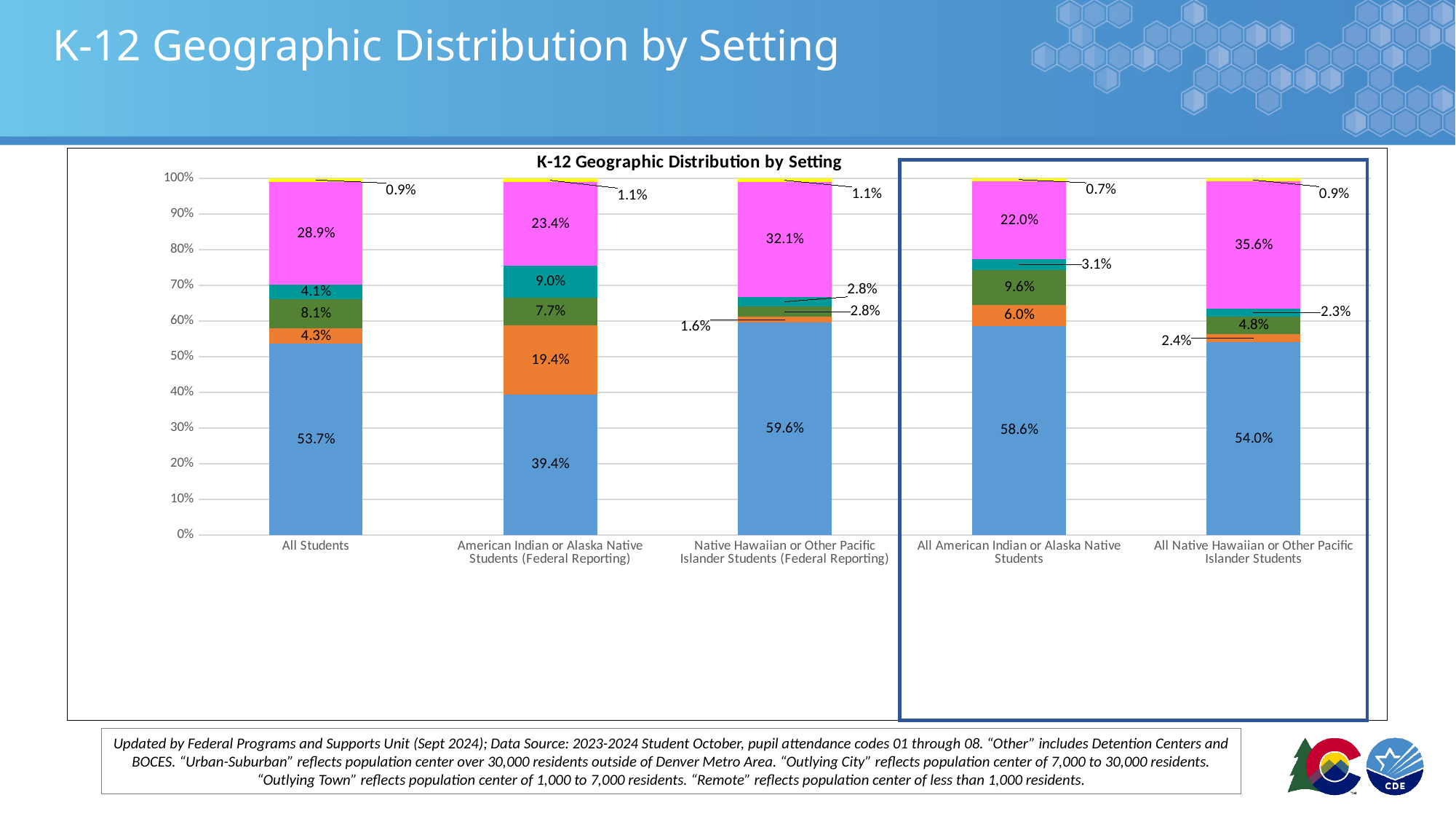
What is the difference between the magenta segment for All Native Hawaiian or Other Pacific Islander Students and the magenta segment for All American Indian or Alaska Native Students? 13.6% What is the value of the orange segment for American Indian or Alaska Native Students (Federal Reporting)? 19.4% Which is larger: the green segment for All American Indian or Alaska Native Students or the green segment for All Students? All American Indian or Alaska Native Students What is the value of the top (yellow) segment for All American Indian or Alaska Native Students? 0.7% What is the value of the bottom (blue) segment for American Indian or Alaska Native Students (Federal Reporting)? 39.4% Which category has the smallest bottom (blue) segment? American Indian or Alaska Native Students (Federal Reporting) What is the value of the magenta segment for All Native Hawaiian or Other Pacific Islander Students? 35.6% What is the title of the chart? K-12 Geographic Distribution by Setting How many categories are shown along the x axis of the chart? 5 What is the value of the bottom (blue) segment for All Students? 53.7% Which category has the largest bottom (blue) segment? Native Hawaiian or Other Pacific Islander Students (Federal Reporting) What type of chart is shown on the slide? Stacked bar chart